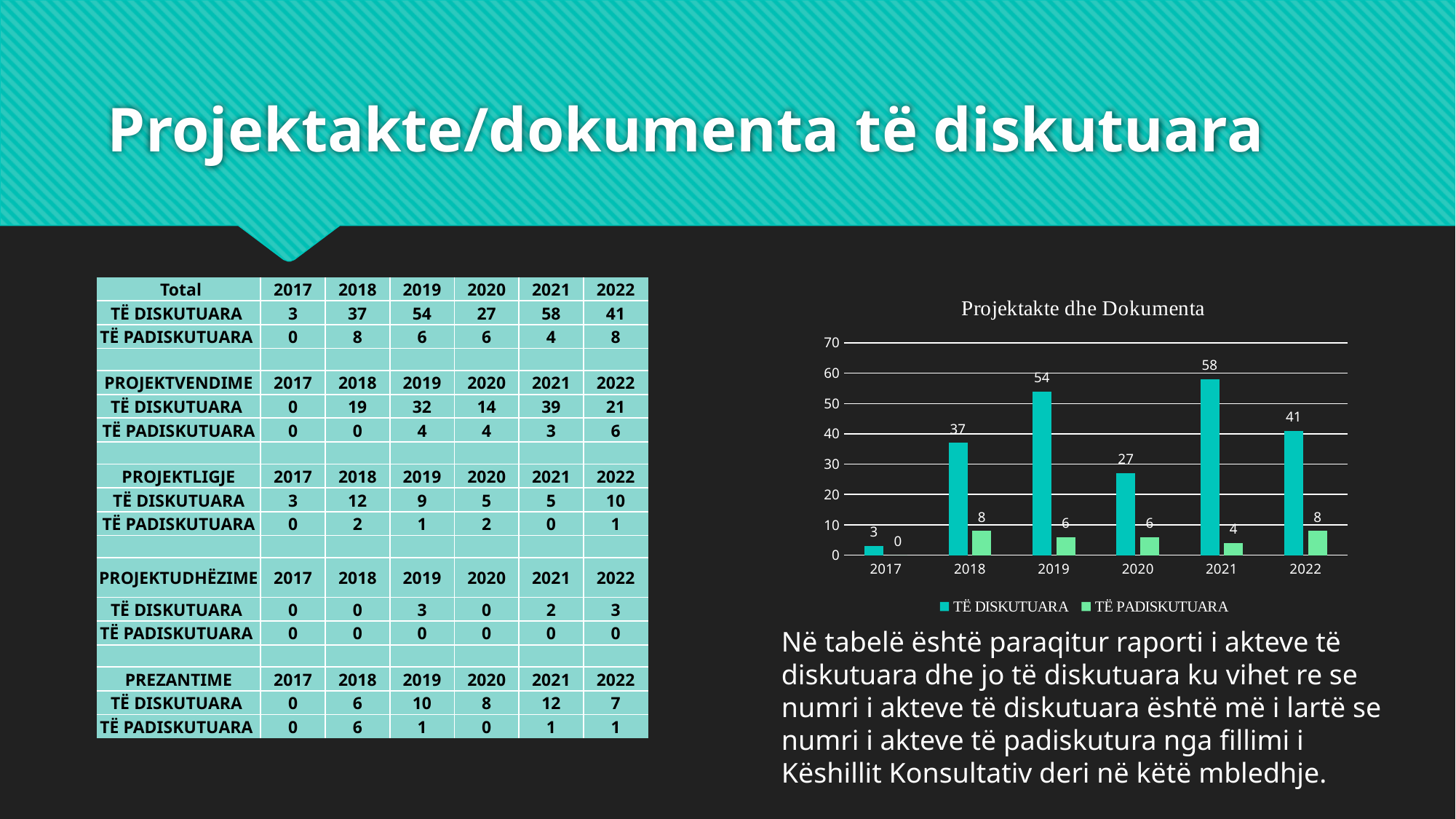
Which year has the lowest value for TË DISKUTUARA? 2017 What is the value for TË PADISKUTUARA in 2021? 4 Which year has the highest value for TË DISKUTUARA? 2021 What is the difference between TË DISKUTUARA and TË PADISKUTUARA in 2022? 33 Is the value for TË DISKUTUARA in 2021 greater or less than 50? greater How many years are shown on the x axis of the chart? 6 What kind of chart is shown on the slide? bar chart What is the value for TË DISKUTUARA in 2019? 54 How many series does the chart legend list? 2 What is the title of the chart? Projektakte dhe Dokumenta Which is larger: TË DISKUTUARA in 2018 or TË DISKUTUARA in 2020? 2018 What is the value for TË PADISKUTUARA in 2017? 0